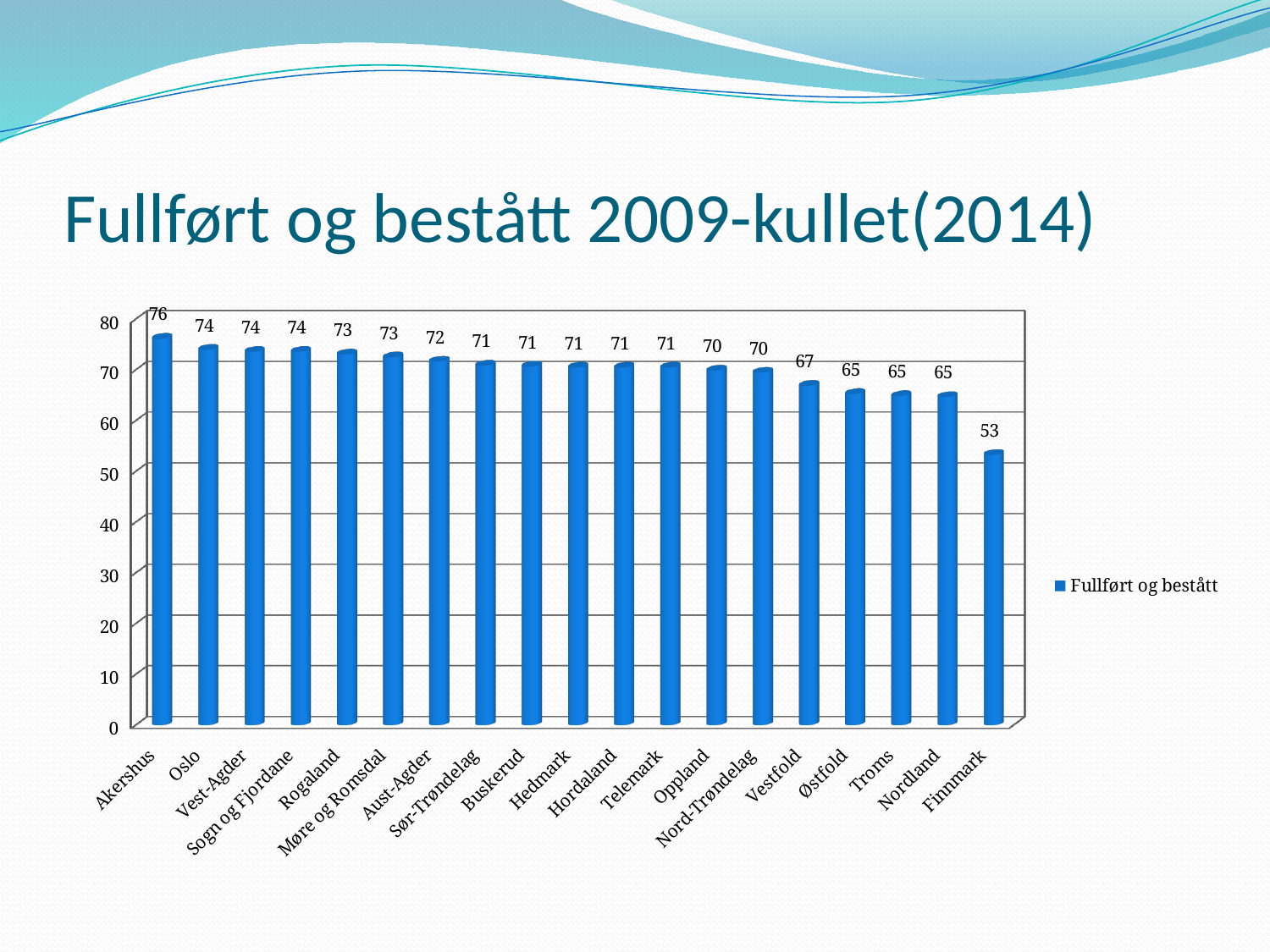
Which category has the lowest value? Finnmark What is the value for Finnmark? 53 Which category has the highest value? Akershus What is the value for Akershus? 76 Which is larger, the value for Oslo or the value for Østfold? Oslo How many categories are shown on the x axis? 19 What is the value for Vestfold? 67 What is the difference between the values for Akershus and Finnmark? 23 How many series does the legend list? 1 What is the legend entry for the series? Fullført og bestått What is the value for Aust-Agder? 72 What kind of chart is shown on the slide? Bar chart